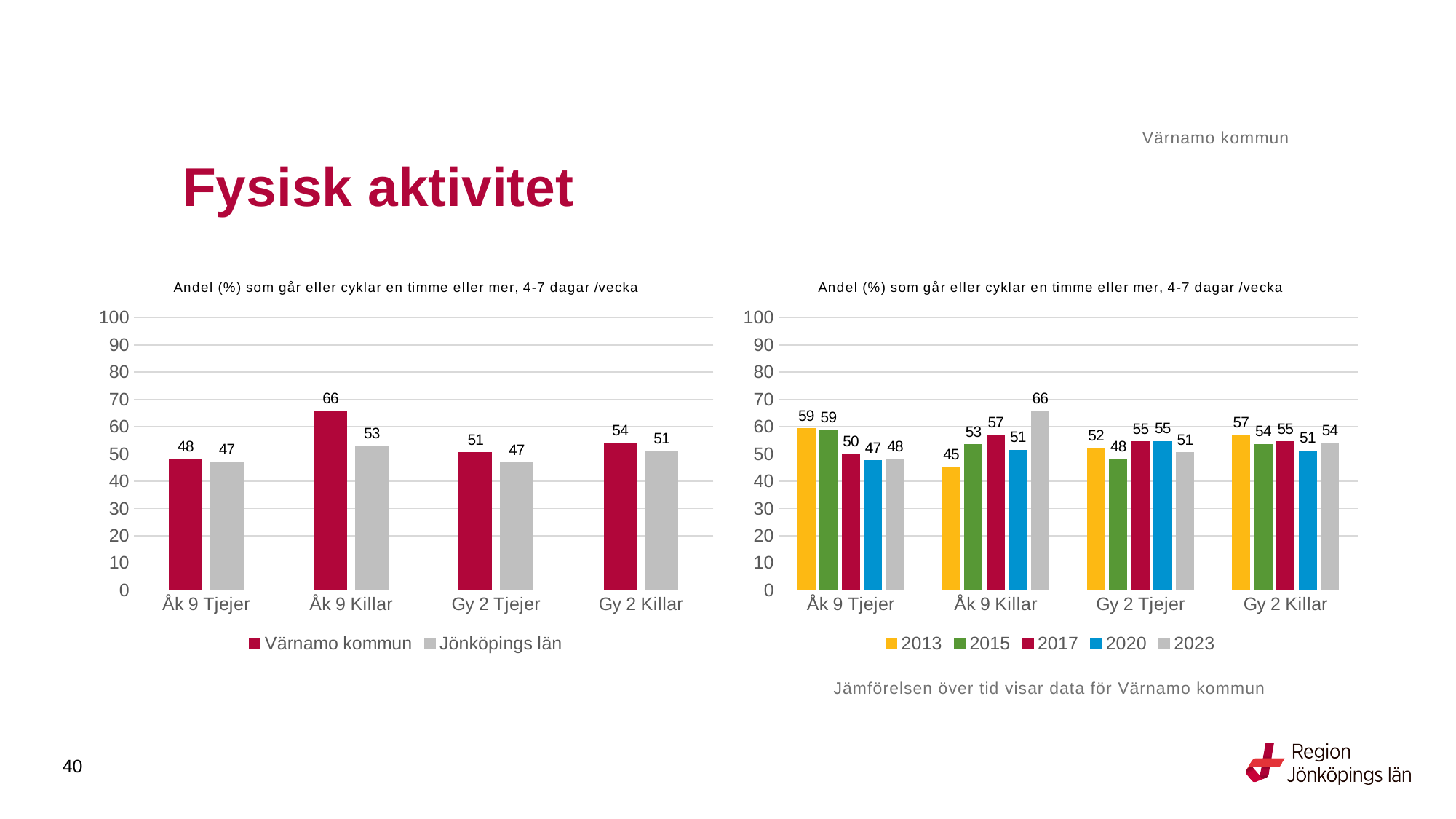
What kind of chart is the left chart? bar chart In the right chart, how many categories are shown on the x axis? 4 In the right chart, which year has the lowest value for Åk 9 Tjejer? 2020 In the right chart, what is the value for 2013 for Åk 9 Killar? 45 In the left chart, what is the value for Jönköpings län for Gy 2 Tjejer? 47 In the left chart, how many series does the legend list? 2 In the right chart, how many series does the legend list? 5 In the right chart, is the value for 2017 for Gy 2 Tjejer larger or smaller than the value for 2015 for Gy 2 Tjejer? larger In the left chart, what is the difference between Värnamo kommun and Jönköpings län for Åk 9 Killar? 13 In the left chart, which category has the highest value for Värnamo kommun? Åk 9 Killar In the right chart, what is the value for 2023 for Gy 2 Killar? 54 In the left chart, what is the value for Värnamo kommun for Åk 9 Killar? 66